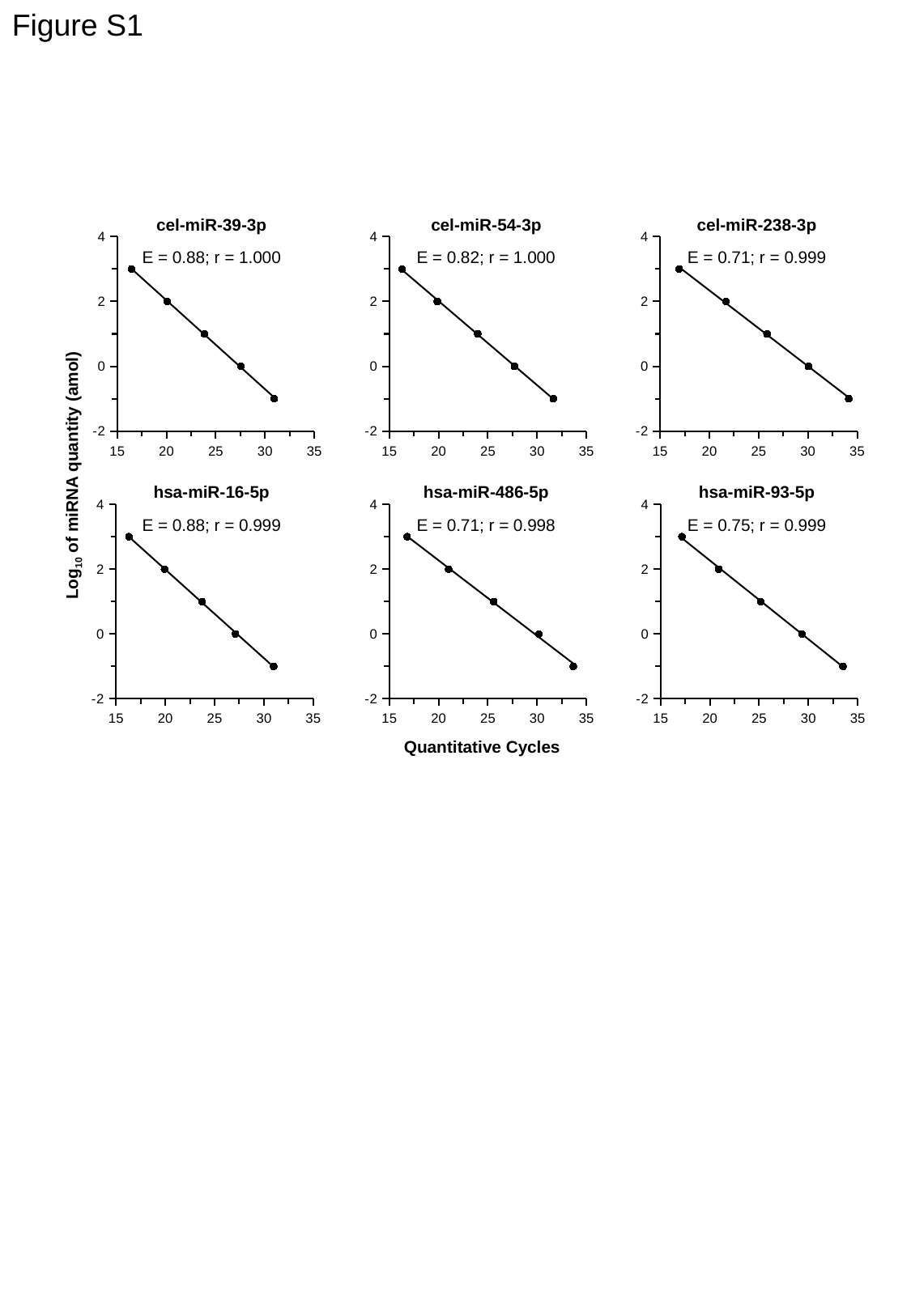
In the hsa-miR-93-5p chart, is the value of the rightmost point greater or less than -2? greater In the cel-miR-54-3p chart, is the value of the leftmost point greater or less than 4? less How many data points are plotted in the hsa-miR-93-5p chart? 5 In the cel-miR-39-3p chart, is the value of the rightmost point greater or less than 0? less What is the E value printed on the hsa-miR-486-5p chart? E = 0.71 What is the x-axis label shared by the six charts? Quantitative Cycles In the cel-miR-238-3p chart, do the values rise or fall as Quantitative Cycles increase? fall In the hsa-miR-486-5p chart, do the values rise or fall along the x axis? fall What kind of chart is the cel-miR-39-3p chart? scatter plot with a fitted line In the cel-miR-238-3p chart, which is larger: the value of the leftmost point or the value of the rightmost point? the leftmost point How many data points are plotted in the cel-miR-54-3p chart? 5